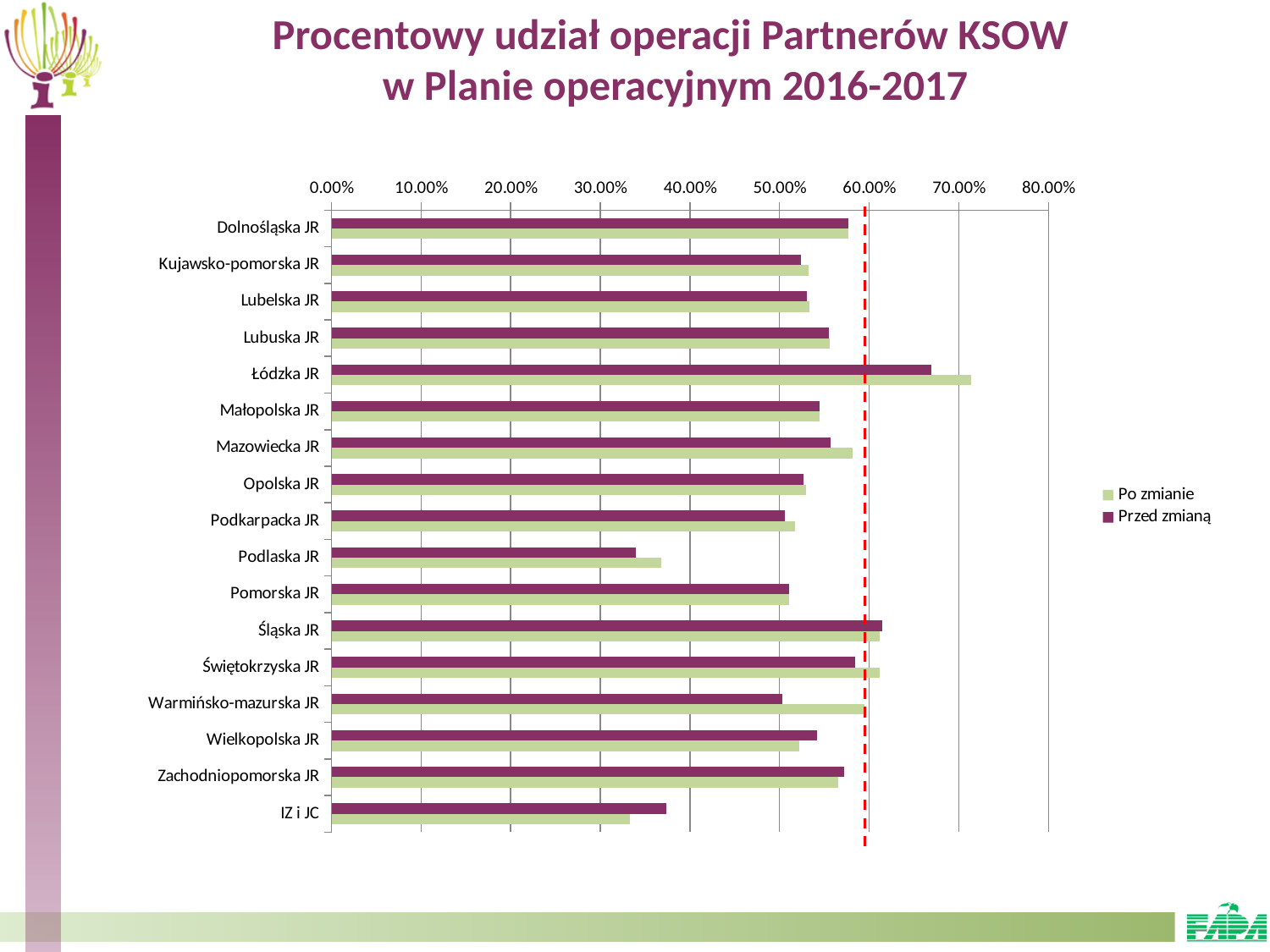
How many series does the legend list? 2 How many categories are shown on the vertical axis of the chart? 17 For Łódzka JR, which series has the larger value, 'Po zmianie' or 'Przed zmianą'? Po zmianie What kind of chart is shown on the slide? bar chart Is the 'Przed zmianą' value for Łódzka JR greater or less than 60.00%? greater Which category has the lowest value for the 'Przed zmianą' series? Podlaska JR At which value on the horizontal axis is the red dashed vertical line drawn? 60.00% Which category has the highest value for the 'Po zmianie' series? Łódzka JR For Warmińsko-mazurska JR, which series has the larger value, 'Po zmianie' or 'Przed zmianą'? Po zmianie Is the 'Po zmianie' value for Dolnośląska JR greater or less than 50.00%? greater Which category has the highest value for the 'Przed zmianą' series? Łódzka JR Is the 'Przed zmianą' value for Podlaska JR greater or less than 40.00%? less